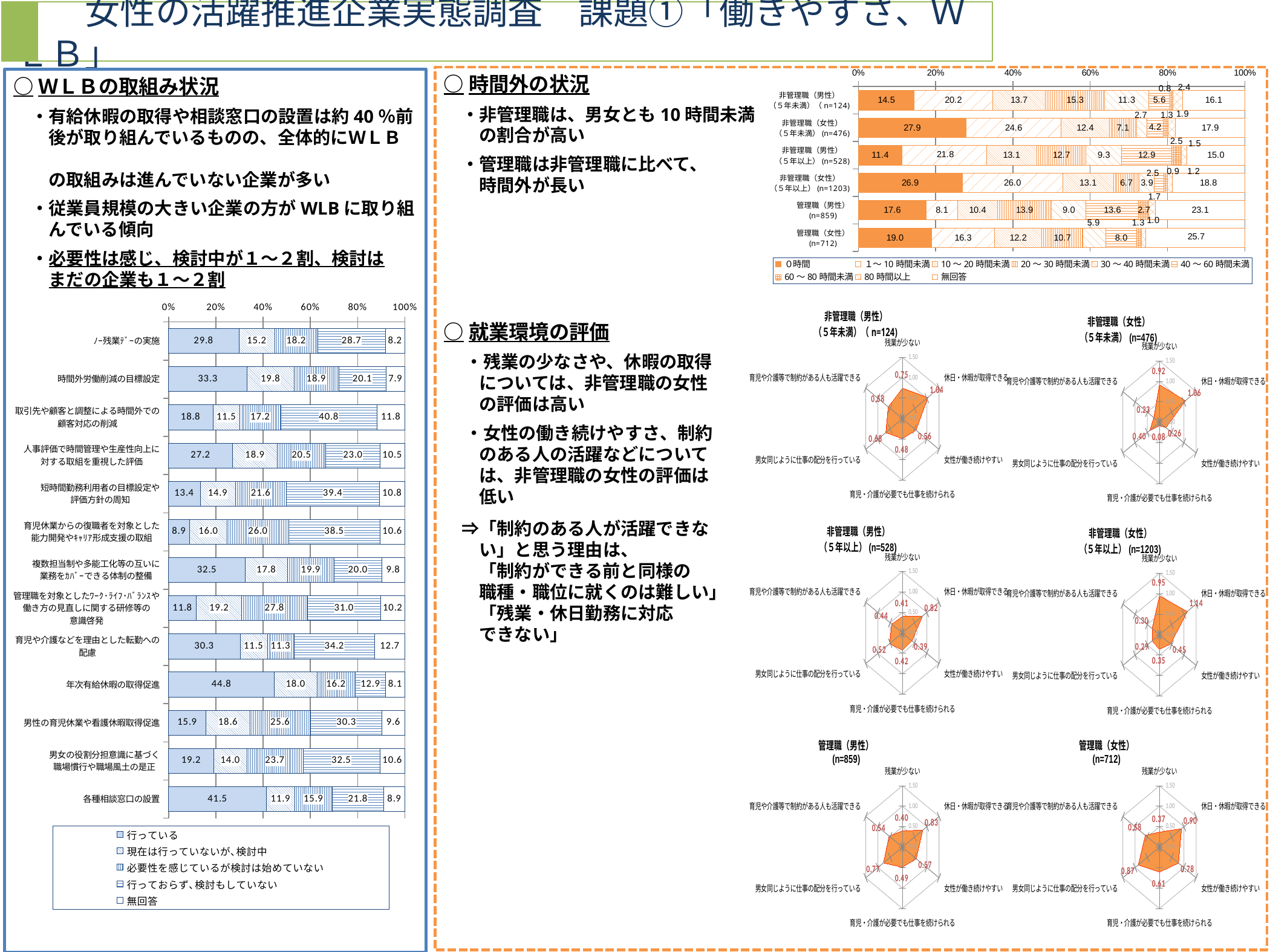
In the top-right stacked bar chart on overtime hours, which group has the highest 0時間 value? 非管理職（女性）（5年未満）(n=476) In the left stacked bar chart on WLB initiatives, what is the difference between the 行っている values for 年次有給休暇の取得促進 and 各種相談窓口の設置? 3.3 In the left stacked bar chart on WLB initiatives, what is the value of 行っている for 各種相談窓口の設置? 41.5 In the top-right stacked bar chart on overtime hours, how many groups are plotted? 6 In the left stacked bar chart on WLB initiatives, how many categories are plotted? 13 In the left stacked bar chart on WLB initiatives, what is the value of 行っている for 年次有給休暇の取得促進? 44.8 In the top-right stacked bar chart on overtime hours, what kind of chart is it? Stacked bar chart In the left stacked bar chart on WLB initiatives, how many series does the legend list? 5 In the radar chart for 管理職（男性）(n=859), what is the value for 残業が少ない? 0.40 In the top-right stacked bar chart on overtime hours, what is the 0時間 value for 管理職（女性）(n=712)? 19.0 In the left stacked bar chart on WLB initiatives, which category has the highest 行っている value? 年次有給休暇の取得促進 In the left stacked bar chart on WLB initiatives, which category has the lowest 行っている value? 育児休業からの復職者を対象とした能力開発やキャリア形成支援の取組